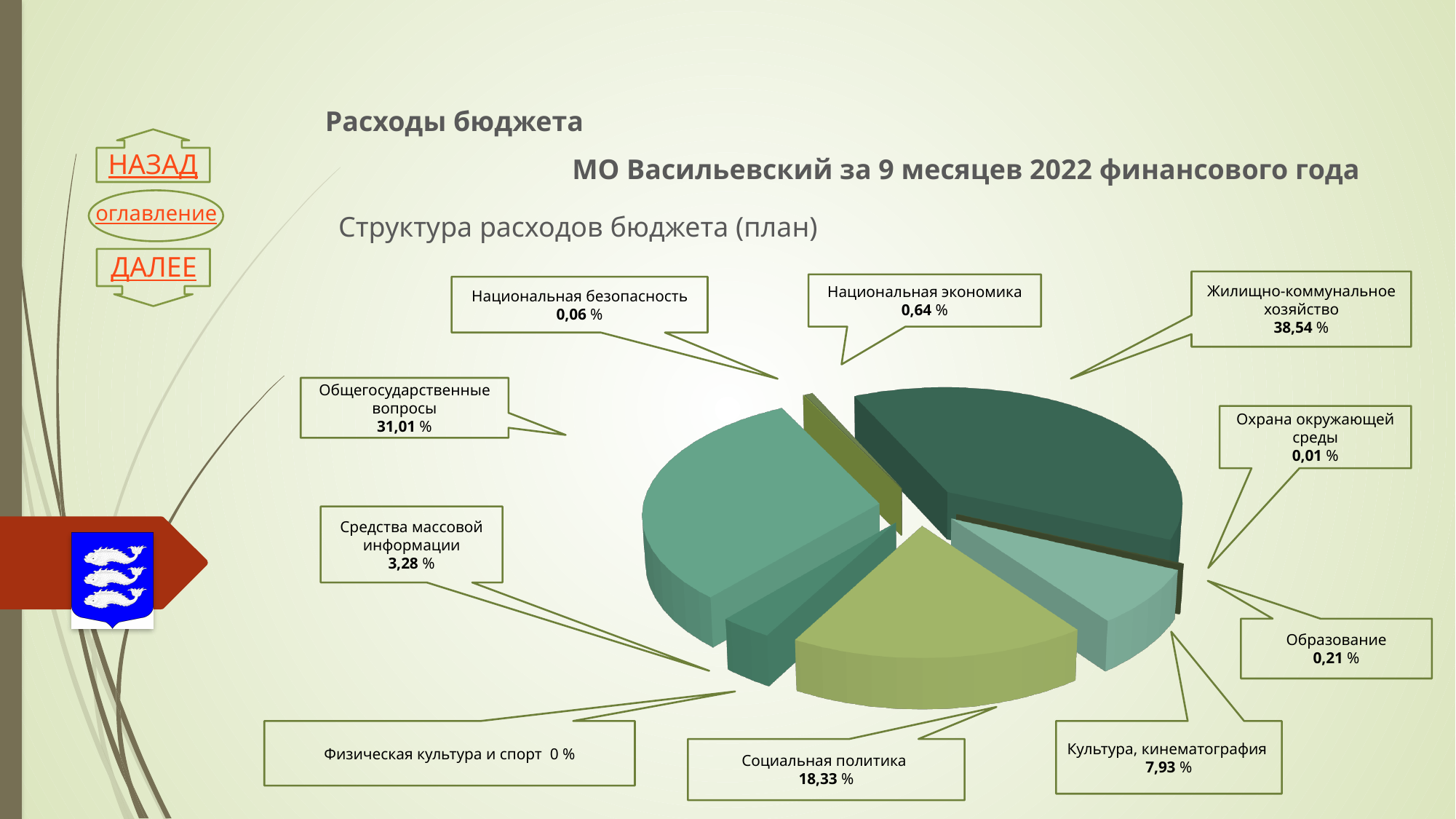
Which category has the smallest share of the pie? Физическая культура и спорт How many categories are labelled in the pie chart? 10 Which is larger: the share of Социальная политика or Культура, кинематография? Социальная политика What is the value shown for Культура, кинематография? 7,93 % Which category has the largest share of the pie? Жилищно-коммунальное хозяйство What is the difference between the shares of Жилищно-коммунальное хозяйство and Общегосударственные вопросы? 7,53 % What is the share of Общегосударственные вопросы? 31,01 % What kind of chart is shown on the slide? pie chart What is the share of Жилищно-коммунальное хозяйство in the pie chart? 38,54 % What is the value shown for Охрана окружающей среды? 0,01 % What is the value shown for Социальная политика? 18,33 % What is the value shown for Средства массовой информации? 3,28 %